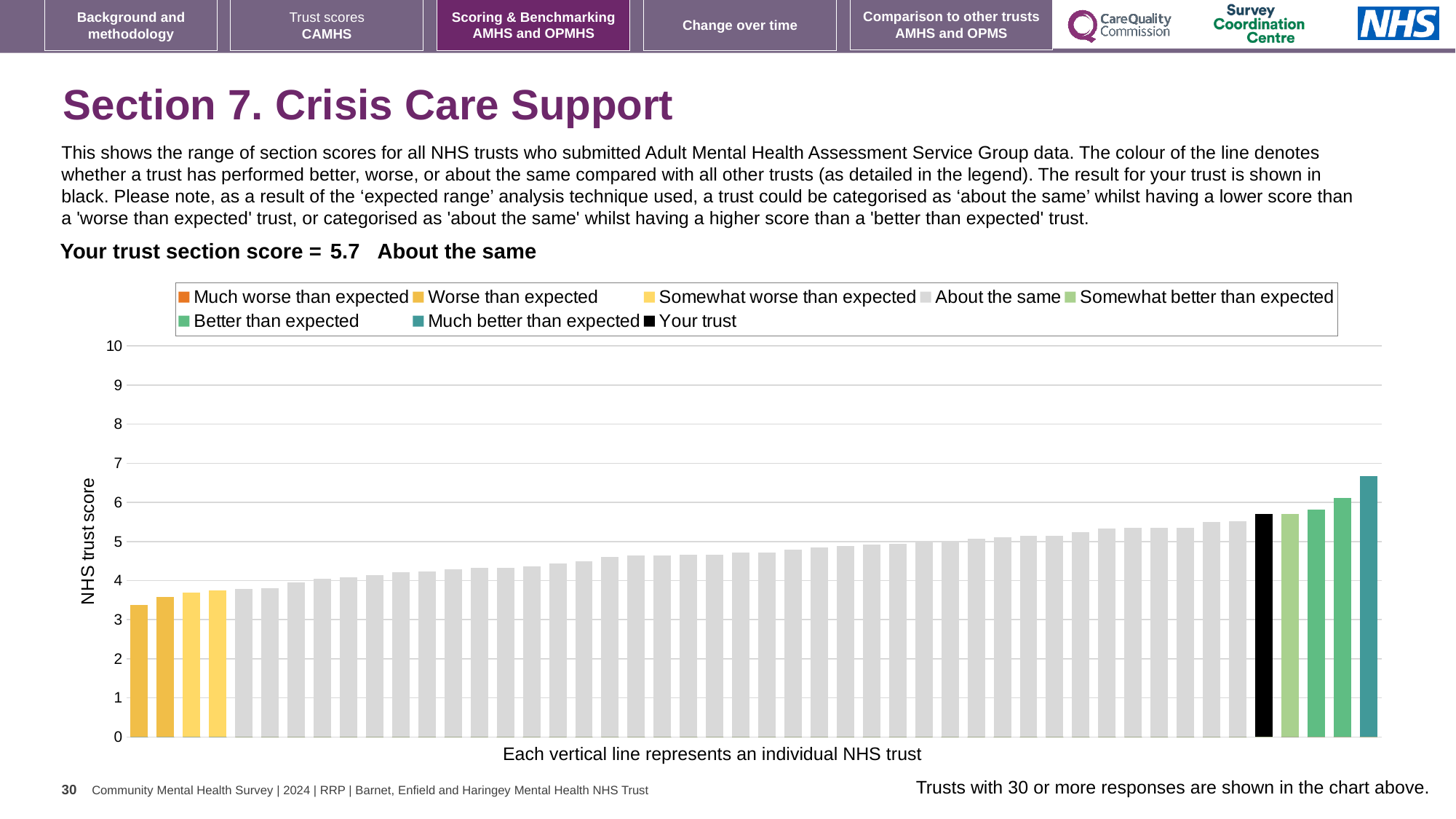
Is the value of the tallest bar in the chart greater or less than 6? greater How many entries does the chart legend list? 8 Which legend category does the tallest bar in the chart belong to? Much better than expected Do the bar values rise or fall from left to right across the chart? Rise Is the value of the bar for your trust greater or less than 5? greater What is the label on the vertical axis of the chart? NHS trust score What is the section score for your trust shown on the slide? 5.7 What colour is used for the bar representing your trust? Black Is your trust's bar taller or shorter than the tallest bar in the chart? Shorter Which performance category is your trust placed in for Crisis Care Support? About the same What kind of chart is shown on the slide? Bar chart Is the value of the leftmost (shortest) bar greater or less than 4? less